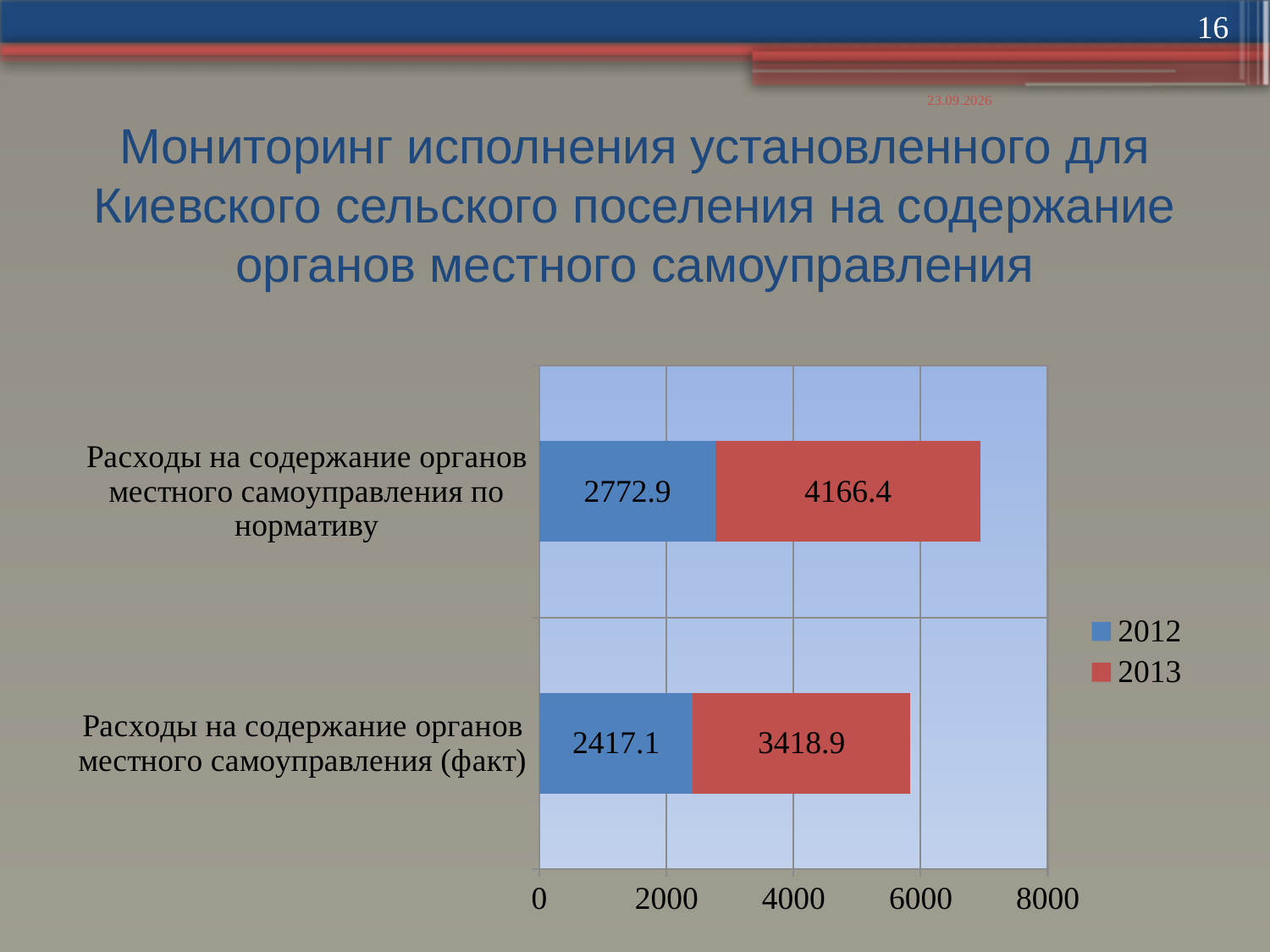
How many series does the legend list? 2 What type of chart is shown on the slide? Stacked bar chart What is the total of the stacked bar for 'Расходы на содержание органов местного самоуправления (факт)'? 5836.0 How many categories are shown on the chart? 2 What is the 2013 value for 'Расходы на содержание органов местного самоуправления (факт)'? 3418.9 Which colour represents the 2013 series in the legend? Red What is the 2012 value for 'Расходы на содержание органов местного самоуправления по нормативу'? 2772.9 What is the 2012 value for 'Расходы на содержание органов местного самоуправления (факт)'? 2417.1 Which is larger: the 2013 value for 'по нормативу' or the 2013 value for '(факт)'? 2013 value for 'по нормативу' (4166.4) What is the 2013 value for 'Расходы на содержание органов местного самоуправления по нормативу'? 4166.4 What is the difference between the 2013 and 2012 values for 'Расходы на содержание органов местного самоуправления (факт)'? 1001.8 What is the total of the stacked bar for 'Расходы на содержание органов местного самоуправления по нормативу'? 6939.3